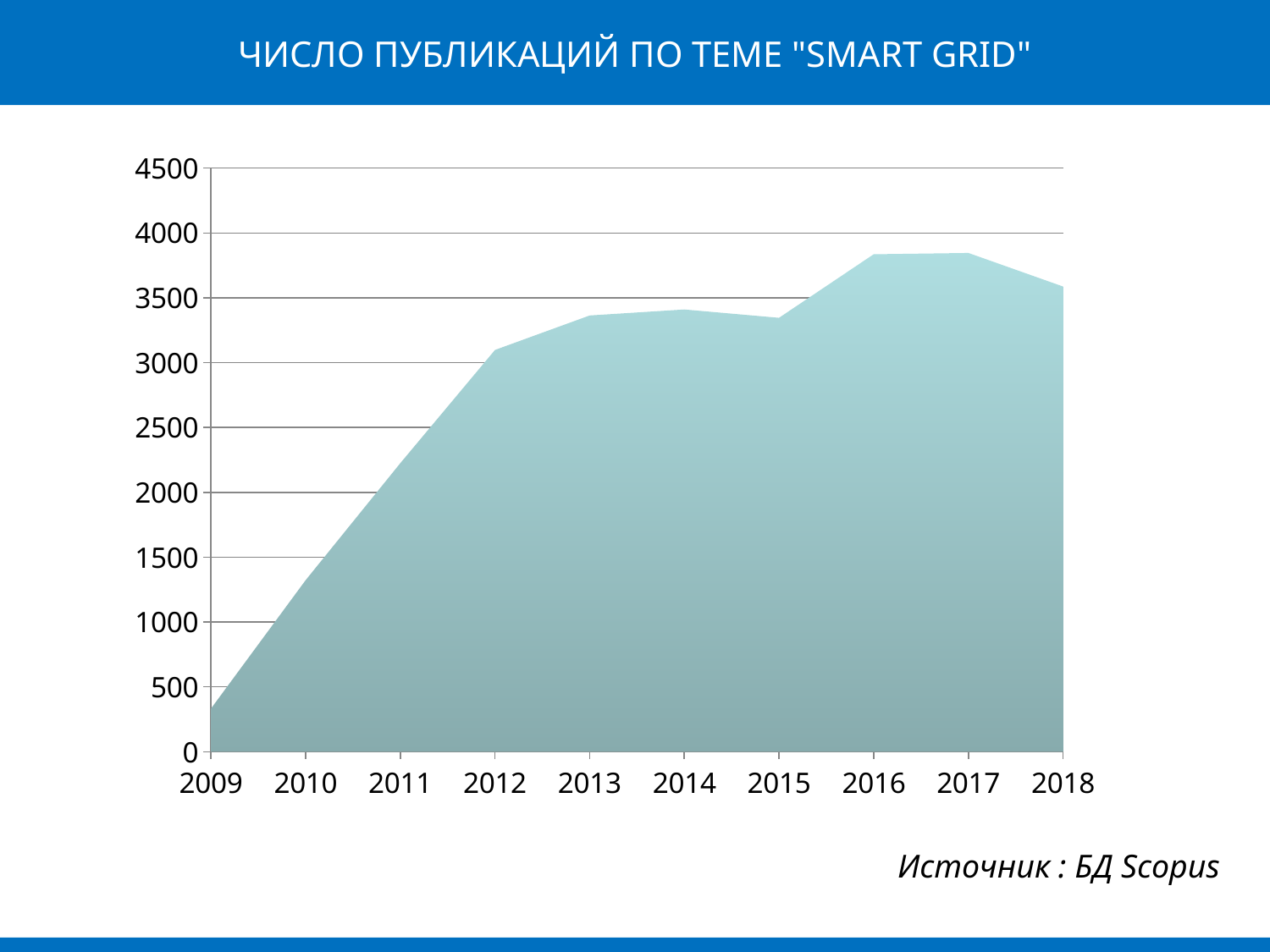
Is the value for 2016 greater or less than 4000? less Is the value for 2018 greater or less than 3500? greater What is the title of the chart? ЧИСЛО ПУБЛИКАЦИЙ ПО ТЕМЕ "SMART GRID" What kind of chart is shown on the slide? area chart Is the value for 2013 greater or less than 3500? less How many years are shown on the x axis of the chart? 10 Which year has the larger value, 2011 or 2012? 2012 Which year has the lowest number of publications? 2009 Do the values rise or fall from 2009 to 2012? rise